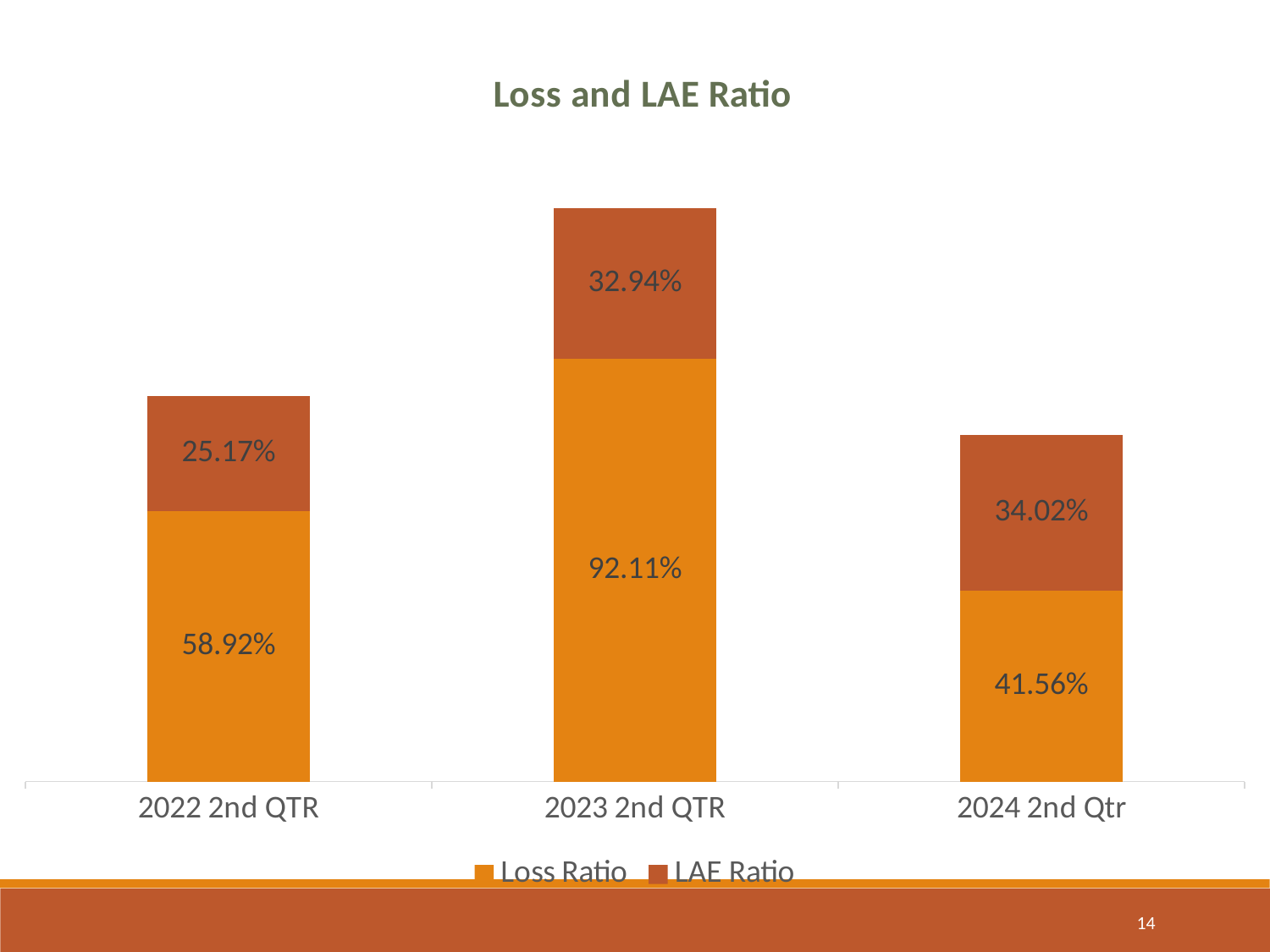
Which is larger, the LAE Ratio for 2022 2nd QTR or the LAE Ratio for 2023 2nd QTR? 2023 2nd QTR What is the title of the chart? Loss and LAE Ratio Which quarter has the lowest LAE Ratio? 2022 2nd QTR What is the total of the stacked bar for 2022 2nd QTR? 84.09% What kind of chart is shown on the slide? Stacked bar chart What is the Loss Ratio for 2023 2nd QTR? 92.11% Which quarter has the highest Loss Ratio? 2023 2nd QTR What is the Loss Ratio for 2022 2nd QTR? 58.92% How many series does the legend list? 2 How many quarters are shown on the x axis? 3 What is the LAE Ratio for 2024 2nd Qtr? 34.02% What is the difference between the Loss Ratio for 2023 2nd QTR and 2024 2nd Qtr? 50.55%